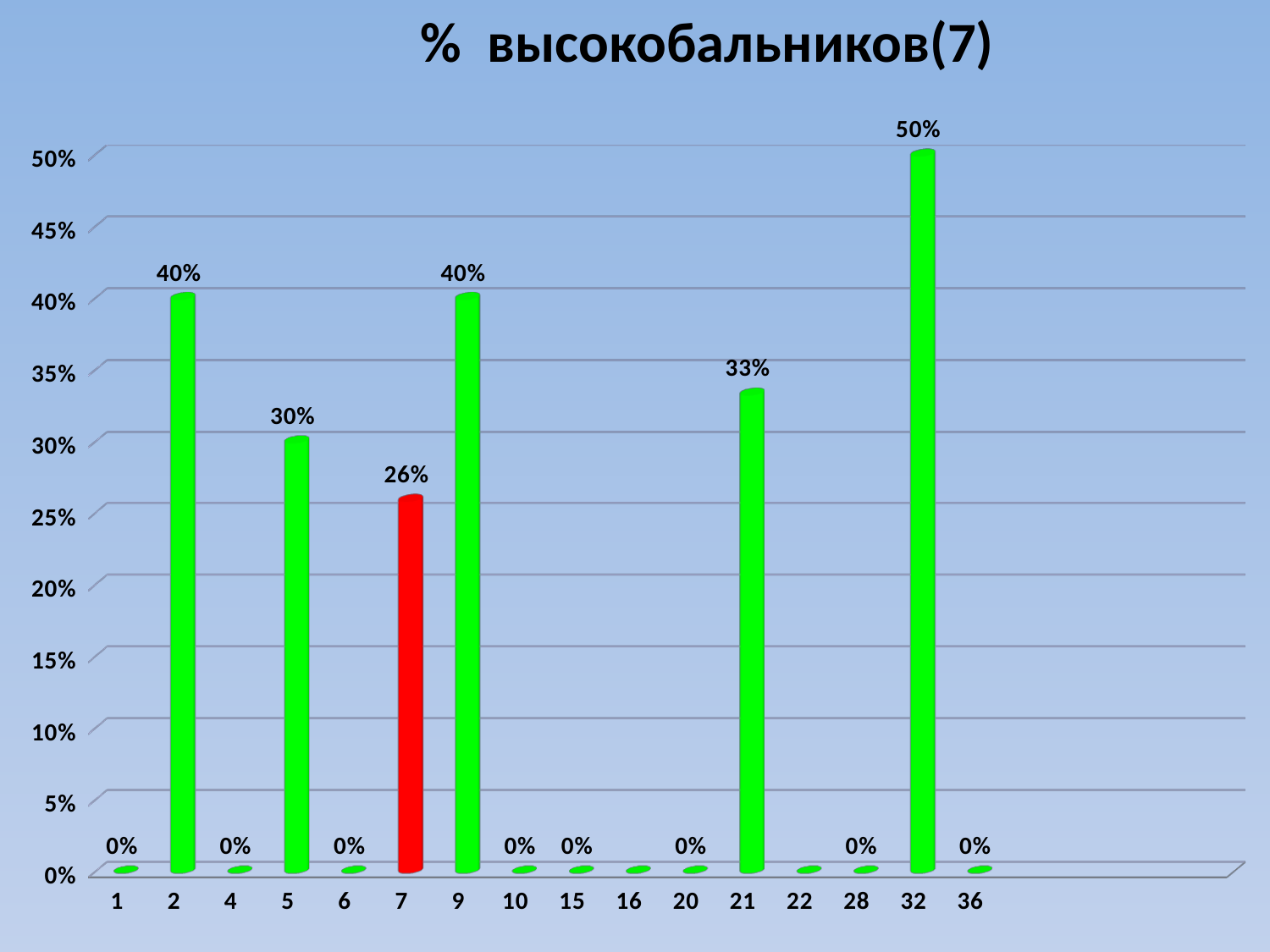
What is the difference between the values for categories 32 and 2? 10% What is the difference between the values for categories 5 and 7? 4% Which category has the highest value? 32 What is the value for category 21? 33% What is the value for category 5? 30% Which has the larger value, category 21 or category 7? 21 How many categories are shown on the x axis? 16 Which category's bar is coloured red? 7 What kind of chart is shown on the slide? bar chart What is the value for category 7? 26% Is the value for category 21 greater or less than 30%? greater What is the value for category 32? 50%